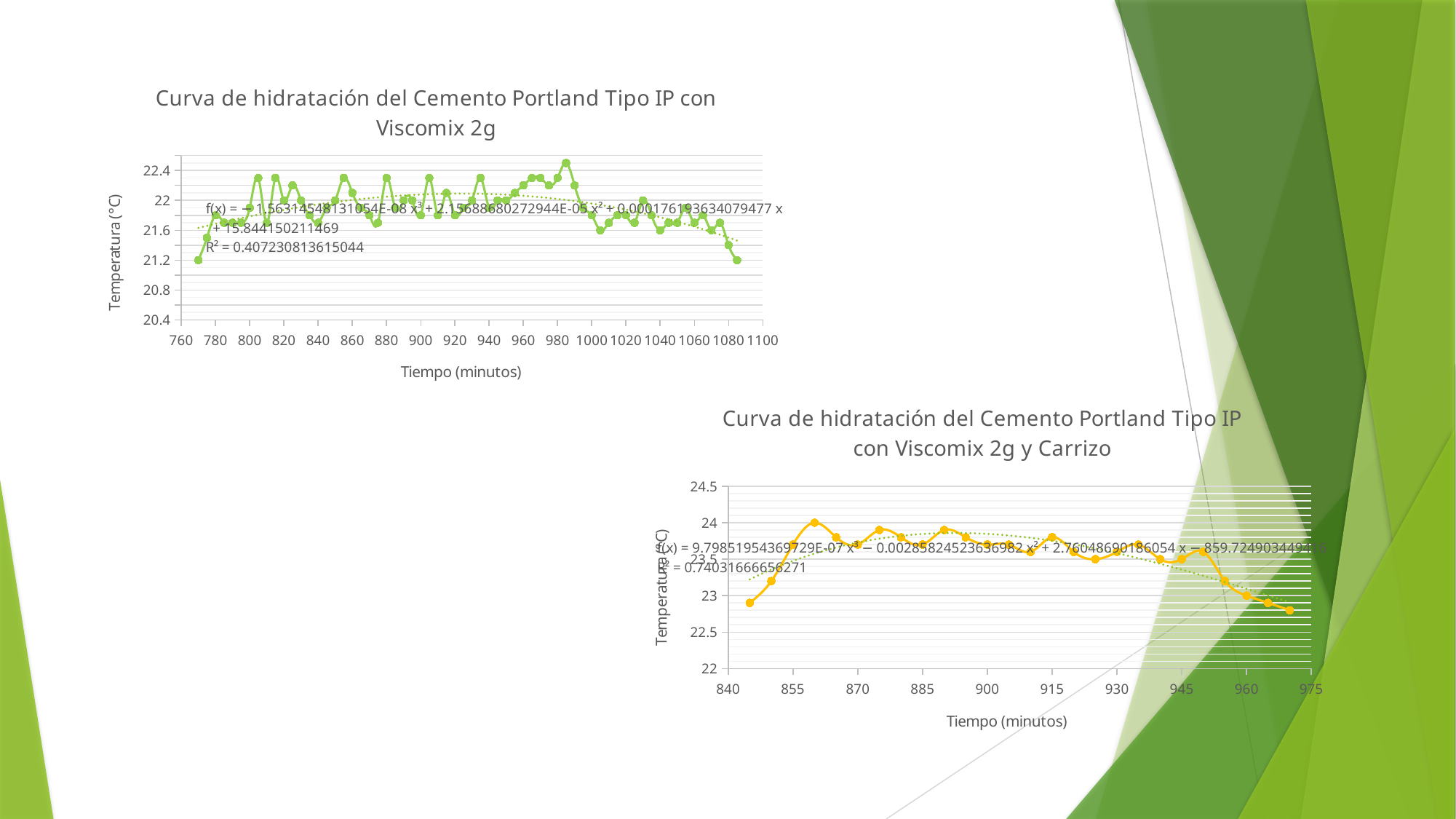
In the 'Viscomix 2g' chart, what R² value is printed for the trendline? 0.407230813615044 Which chart has the higher printed R² value, 'Viscomix 2g' or 'Viscomix 2g y Carrizo'? Viscomix 2g y Carrizo In the 'Viscomix 2g' chart, is the highest temperature (around 985 minutes) greater or less than 22.4? greater What kind of chart is the 'Curva de hidratación del Cemento Portland Tipo IP con Viscomix 2g' chart? line chart In the 'Viscomix 2g y Carrizo' chart, is the peak temperature (around 860 minutes) greater or less than 23.5? greater In the 'Viscomix 2g y Carrizo' chart, do the temperatures rise or fall between 950 and 970 minutes? fall What is the highest value shown on the y-axis of the 'Viscomix 2g y Carrizo' chart? 24.5 In the 'Viscomix 2g' chart, what is the x-axis label? Tiempo (minutos) In the 'Viscomix 2g' chart, is the temperature at the first point (around 770 minutes) greater or less than 21.6? less In the 'Viscomix 2g y Carrizo' chart, what R² value is printed for the trendline? 0.74031666656271 What is the title of the lower-right chart? Curva de hidratación del Cemento Portland Tipo IP con Viscomix 2g y Carrizo